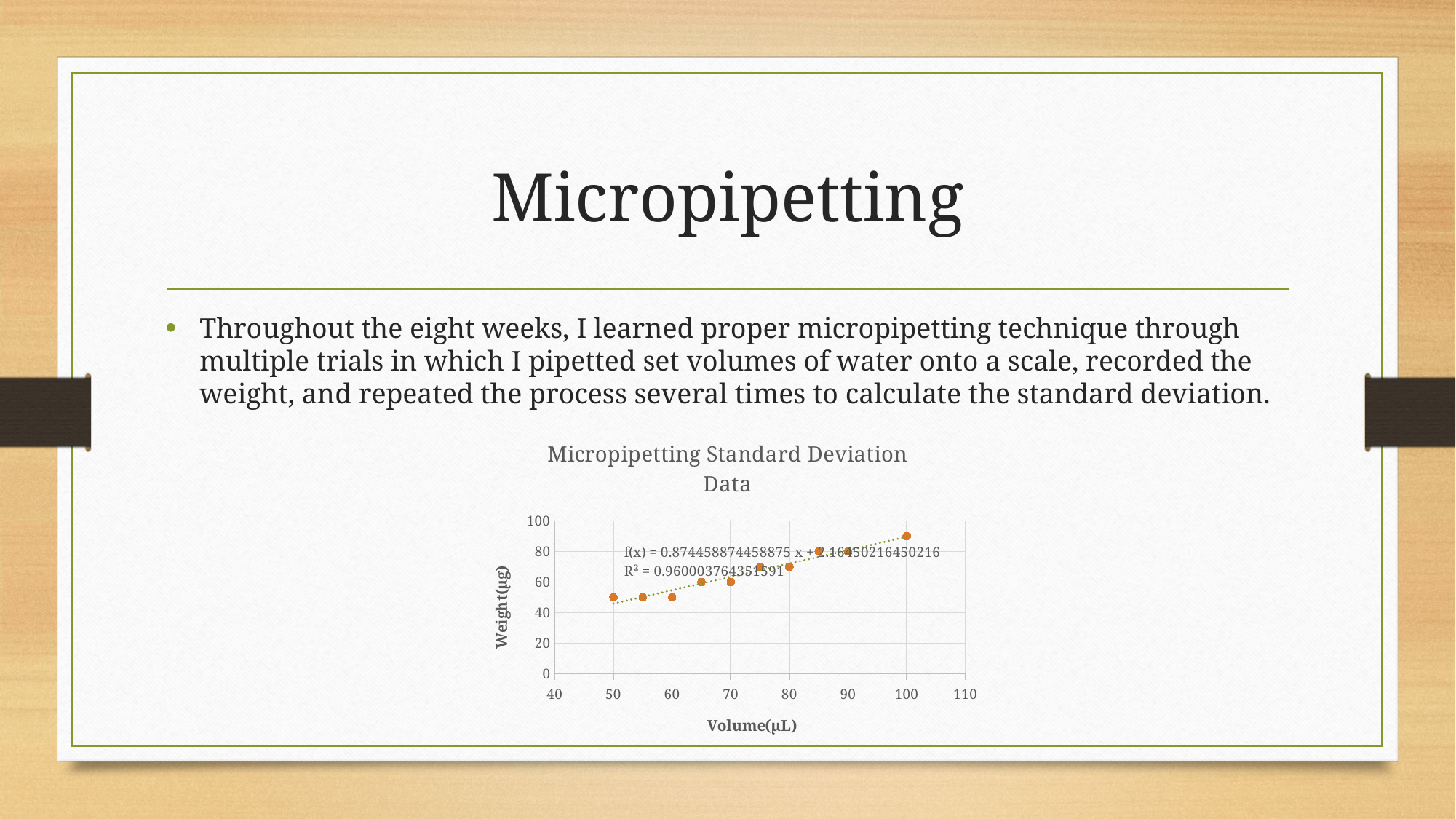
What is the slope of the trendline equation shown on the chart? 0.874458874458875 Do the weight values generally rise or fall as volume increases along the x axis? rise How many data points are plotted in the chart? 10 At which volume is the highest weight recorded? 100 What kind of chart is shown on the slide? scatter chart What is the R² value shown for the trendline? 0.960003764351591 Is the weight value at a volume of 50 µL greater or less than 60? less Is the weight value at a volume of 100 µL greater or less than 80? greater Is the weight value at a volume of 85 µL greater or less than 60? greater What is the label of the x axis? Volume(µL) Which has the larger weight value: the point at 100 µL or the point at 50 µL? 100 µL What is the title of the chart? Micropipetting Standard Deviation Data